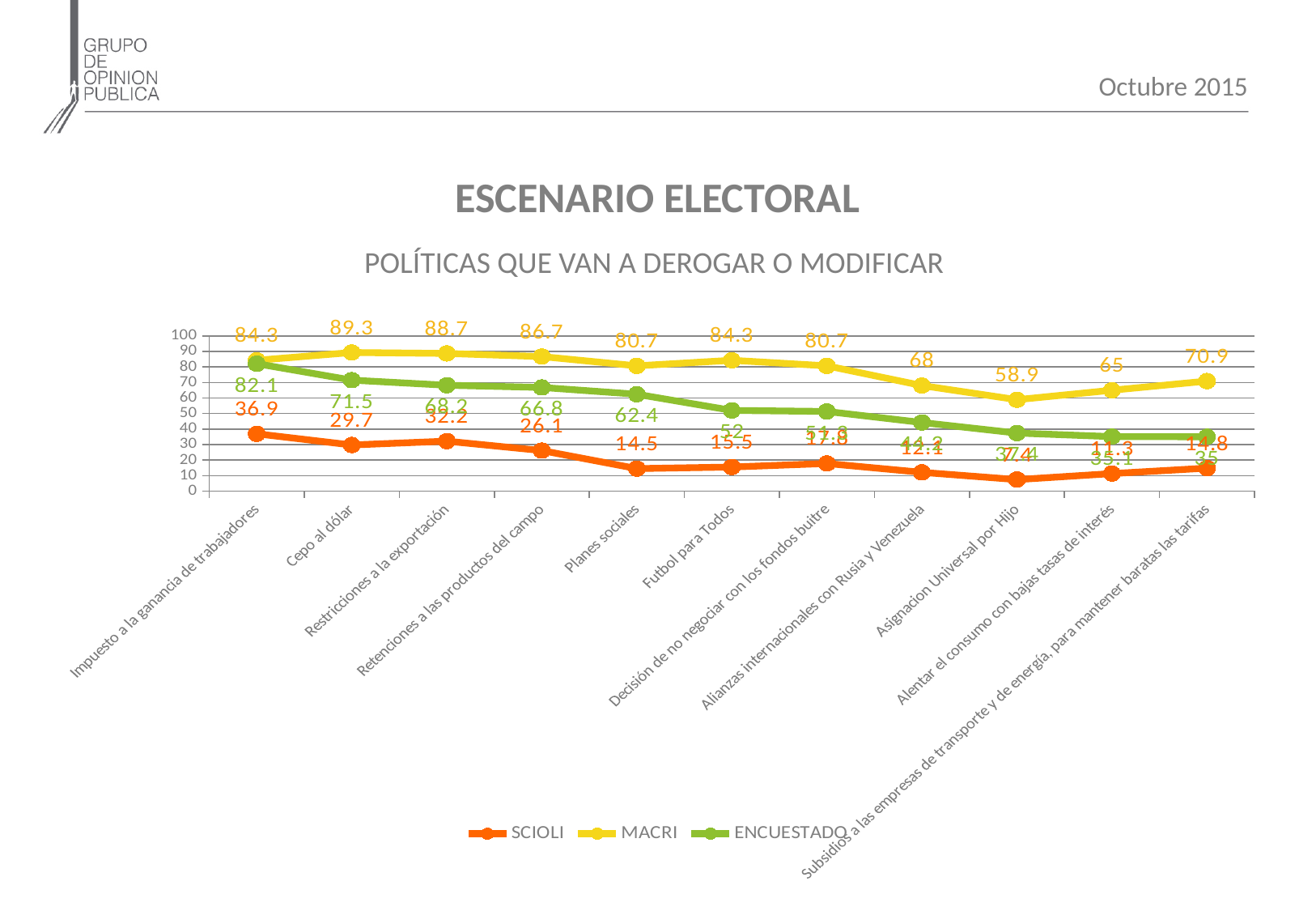
What type of chart is shown on the slide? line chart For which category is the SCIOLI value highest? Impuesto a la ganancia de trabajadores Does the ENCUESTADO series generally rise or fall from left to right along the x axis? fall How many policy categories are plotted on the x axis? 11 What is the MACRI value for Cepo al dólar? 89.3 What is the difference between the MACRI and SCIOLI values for Cepo al dólar? 59.6 For which category is the MACRI value highest? Cepo al dólar Which is larger for Retenciones a las productos del campo, the MACRI value or the ENCUESTADO value? MACRI What is the SCIOLI value for Planes sociales? 14.5 For which category is the MACRI value lowest? Asignacion Universal por Hijo What is the ENCUESTADO value for Futbol para Todos? 52 How many series does the legend list? 3